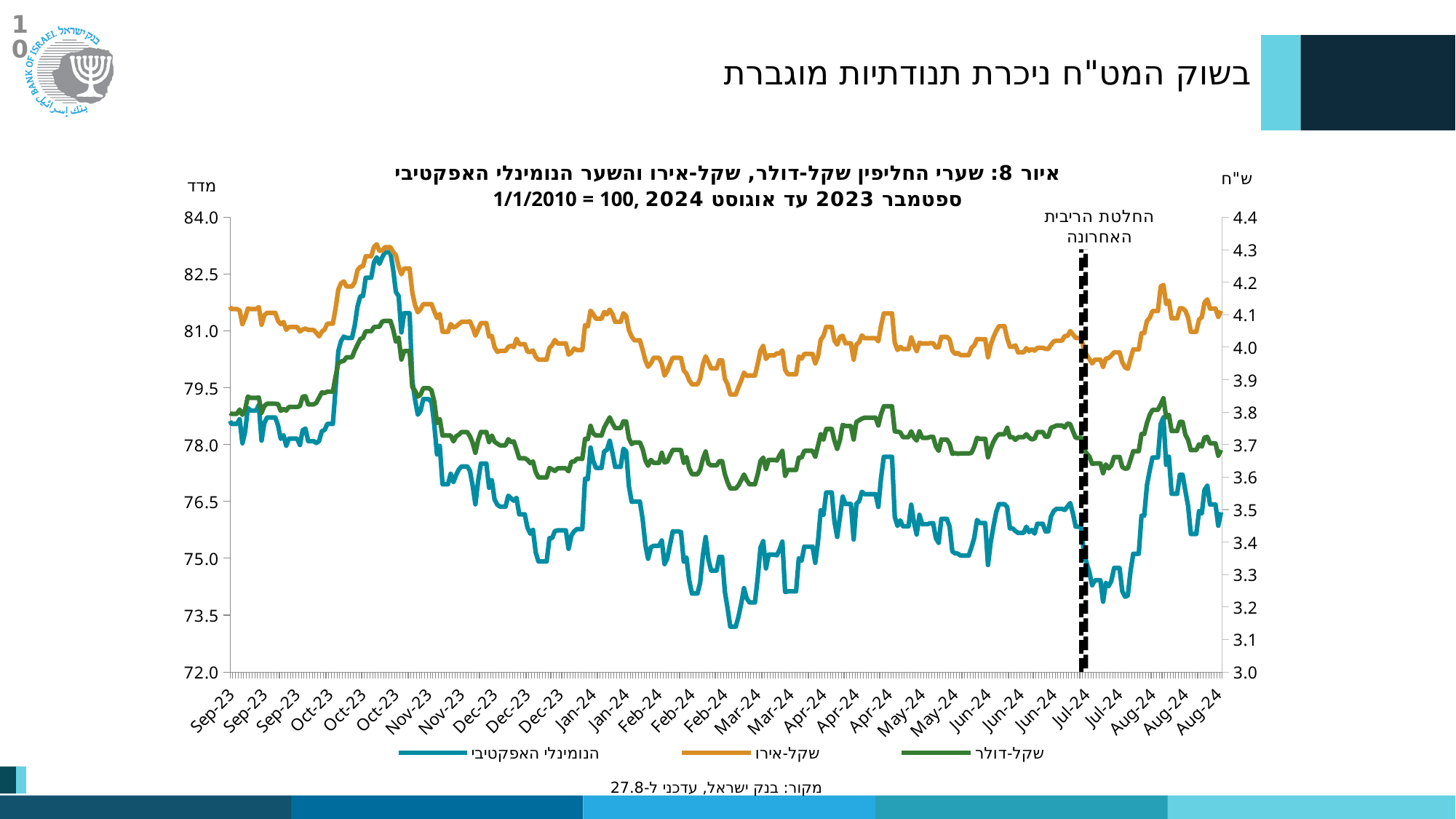
Is the value of the שקל-דולר series at the start of the chart (Sep-23) greater or less than 3.7? greater Which series is higher on the right-hand axis throughout the chart, שקל-אירו or שקל-דולר? שקל-אירו Is the lowest point of the שקל-אירו series (around Feb-24) greater or less than 3.9? less Is the lowest point of the הנומינלי האפקטיבי series (around Feb-24) greater or less than 75.0? less What does the dashed vertical line near Jul-24 mark, according to its label? החלטת הריבית האחרונה Does the הנומינלי האפקטיבי series rise or fall from its Oct-23 peak to Feb-24? fall What is the title of the chart (figure number and subject)? איור 8: שערי החליפין שקל-דולר, שקל-אירו והשער הנומינלי האפקטיבי How many series does the legend list? 3 What kind of chart is shown on the slide? line chart